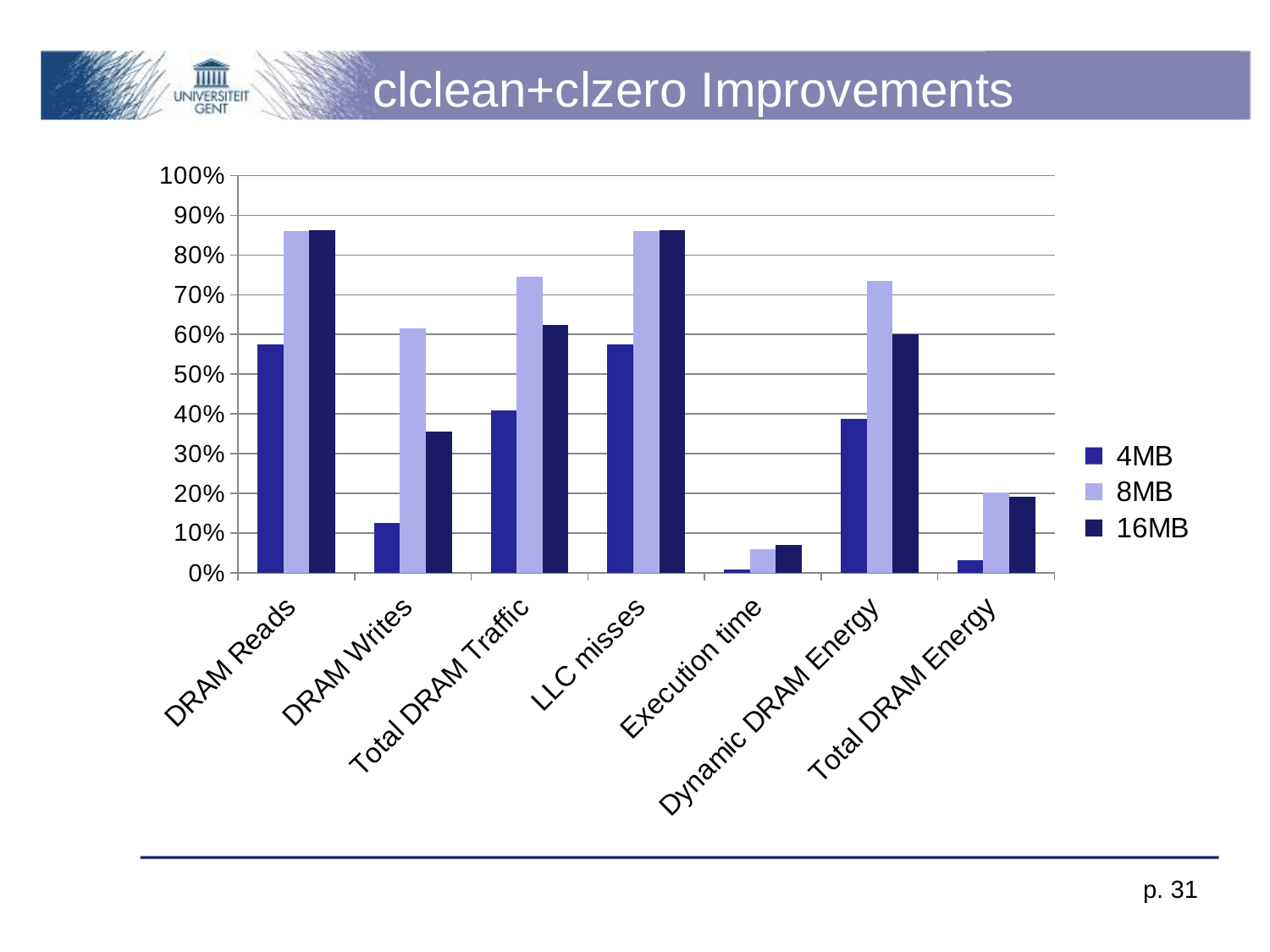
Which category has the lowest value for the 4MB series? Execution time For DRAM Writes, which is larger: the 8MB value or the 16MB value? 8MB Is the 4MB value for Total DRAM Traffic greater or less than 30%? greater What is the title of the slide containing the chart? clclean+clzero Improvements What are the series names listed in the legend? 4MB, 8MB, 16MB Is the 16MB value for Dynamic DRAM Energy greater or less than 50%? greater How many series does the chart's legend list? 3 Is the 8MB value for DRAM Writes greater or less than 50%? greater What kind of chart is shown on the slide? bar chart For the 4MB series, which is larger: the value for DRAM Writes or the value for Total DRAM Energy? DRAM Writes How many categories are shown along the x axis of the chart? 7